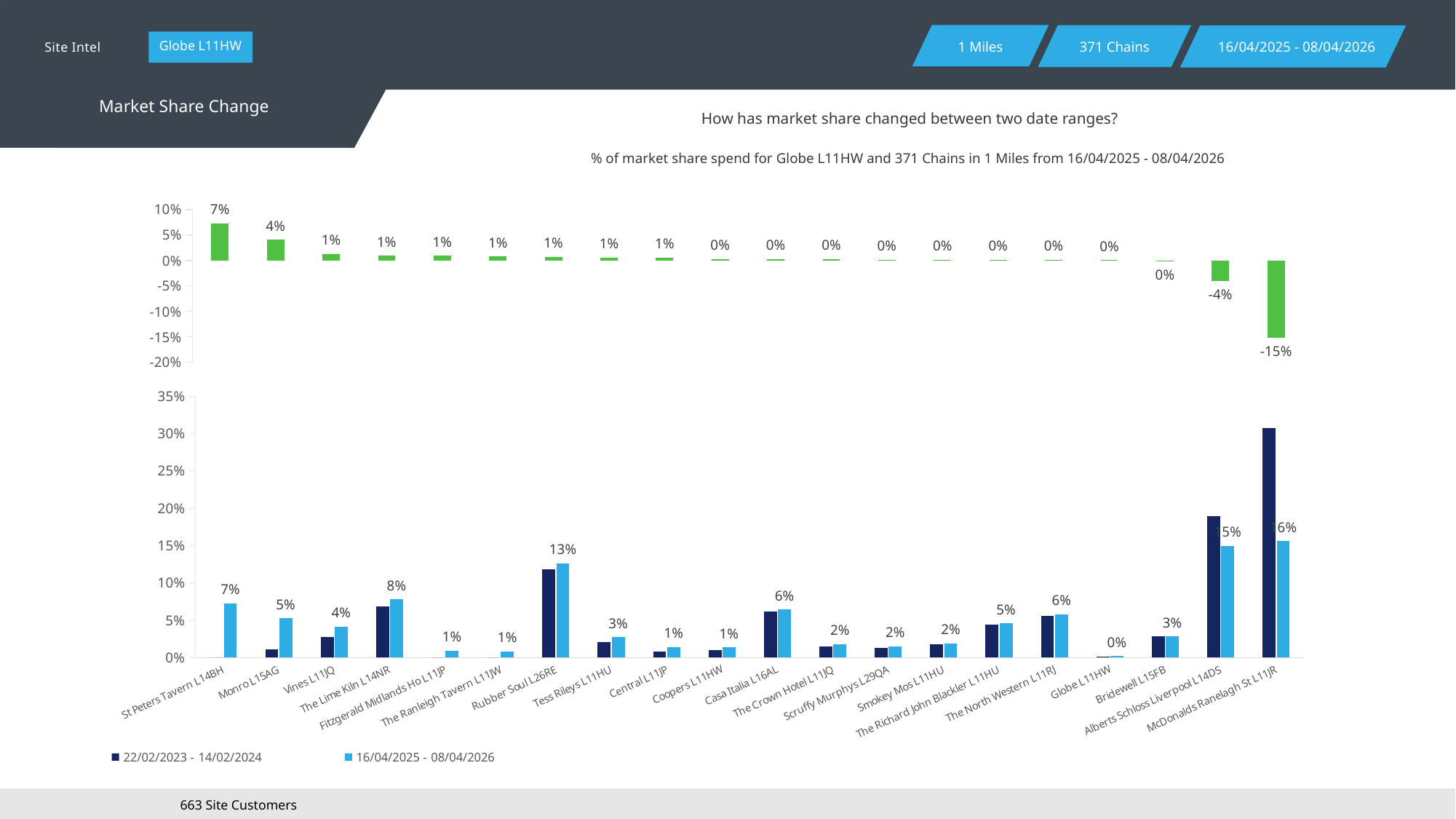
In the bottom chart, which category has the highest value in the 16/04/2025 - 08/04/2026 series? McDonalds Ranelagh St L11JR How many series does the legend of the bottom chart list? 2 In the bottom chart, which is larger for Alberts Schloss Liverpool L14DS: the 22/02/2023 - 14/02/2024 value or the 16/04/2025 - 08/04/2026 value? 22/02/2023 - 14/02/2024 In the top chart, which category has the highest market share change? St Peters Tavern L14BH In the top chart, what is the difference between the market share change for St Peters Tavern L14BH and Monro L15AG? 3% In the top chart, what is the market share change for St Peters Tavern L14BH? 7% In the bottom chart, what is the value for Rubber Soul L26RE in the 16/04/2025 - 08/04/2026 series? 13% In the bottom chart, what is the value for The Lime Kiln L14NR in the 16/04/2025 - 08/04/2026 series? 8% In the top chart, what is the market share change for McDonalds Ranelagh St L11JR? -15% In the bottom chart, is the 22/02/2023 - 14/02/2024 value for McDonalds Ranelagh St L11JR greater or less than 30%? greater In the top chart, which category has the lowest market share change? McDonalds Ranelagh St L11JR How many categories are shown on the x axis of the bottom chart? 20